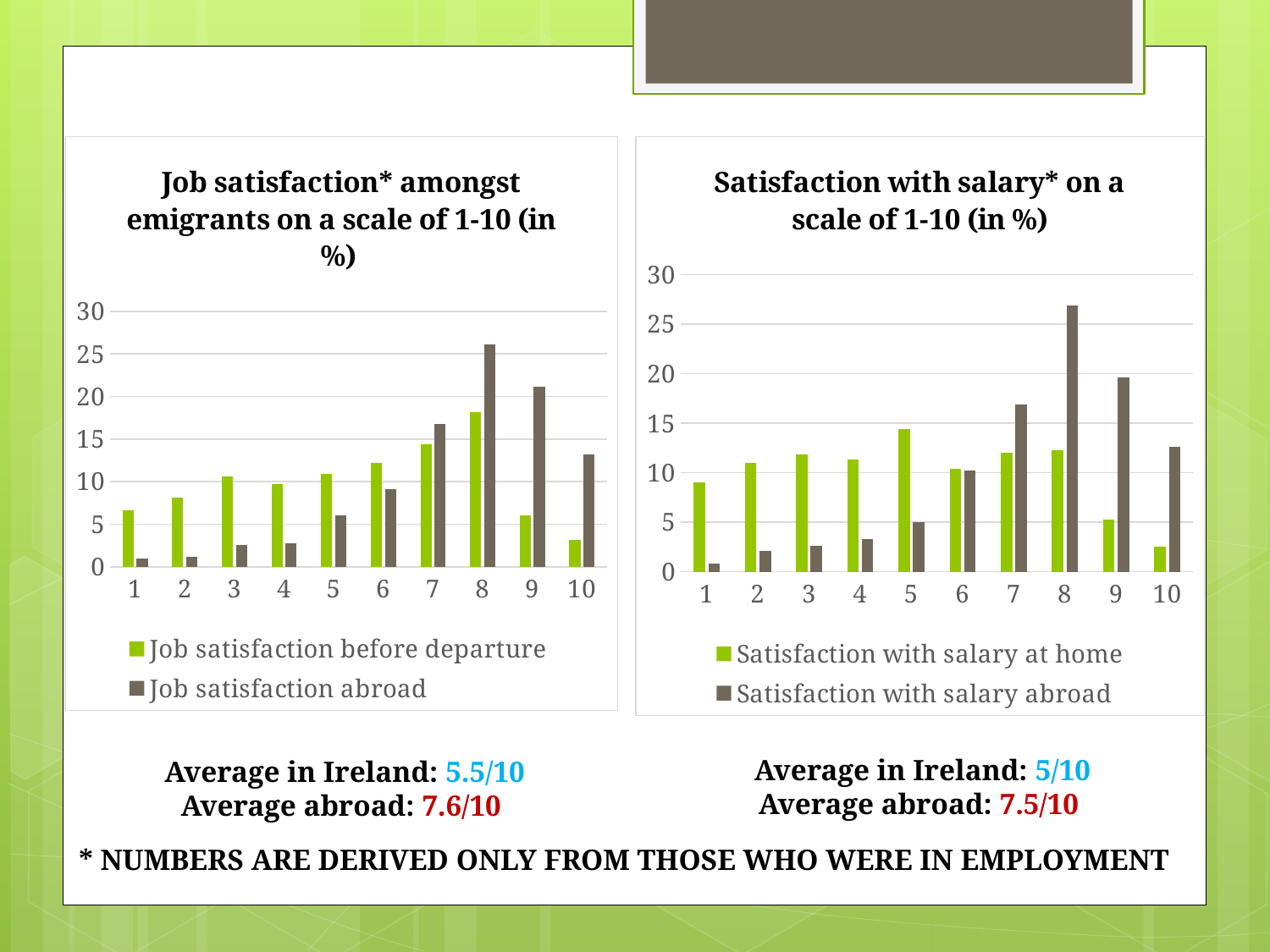
In the chart titled 'Job satisfaction* amongst emigrants on a scale of 1-10 (in %)', which score has the highest value for Job satisfaction abroad? 8 In the chart titled 'Satisfaction with salary* on a scale of 1-10 (in %)', which score has the highest value for Satisfaction with salary abroad? 8 In the chart titled 'Job satisfaction* amongst emigrants on a scale of 1-10 (in %)', is the value for Job satisfaction abroad at score 8 greater or less than 25? greater In the chart titled 'Job satisfaction* amongst emigrants on a scale of 1-10 (in %)', at score 9, which is larger: Job satisfaction before departure or Job satisfaction abroad? Job satisfaction abroad How many series does the legend of the left chart list? 2 In the chart titled 'Satisfaction with salary* on a scale of 1-10 (in %)', at score 9, which is larger: Satisfaction with salary at home or Satisfaction with salary abroad? Satisfaction with salary abroad In the chart titled 'Job satisfaction* amongst emigrants on a scale of 1-10 (in %)', which score has the highest value for Job satisfaction before departure? 8 In the chart titled 'Job satisfaction* amongst emigrants on a scale of 1-10 (in %)', is the value for Job satisfaction before departure at score 10 greater or less than 5? less How many score categories are shown on the x axis of the right chart? 10 In the chart titled 'Satisfaction with salary* on a scale of 1-10 (in %)', is the value for Satisfaction with salary at home at score 5 greater or less than 10? greater In the chart titled 'Satisfaction with salary* on a scale of 1-10 (in %)', which score has the lowest value for Satisfaction with salary abroad? 1 What kind of chart is the chart titled 'Satisfaction with salary* on a scale of 1-10 (in %)'? bar chart